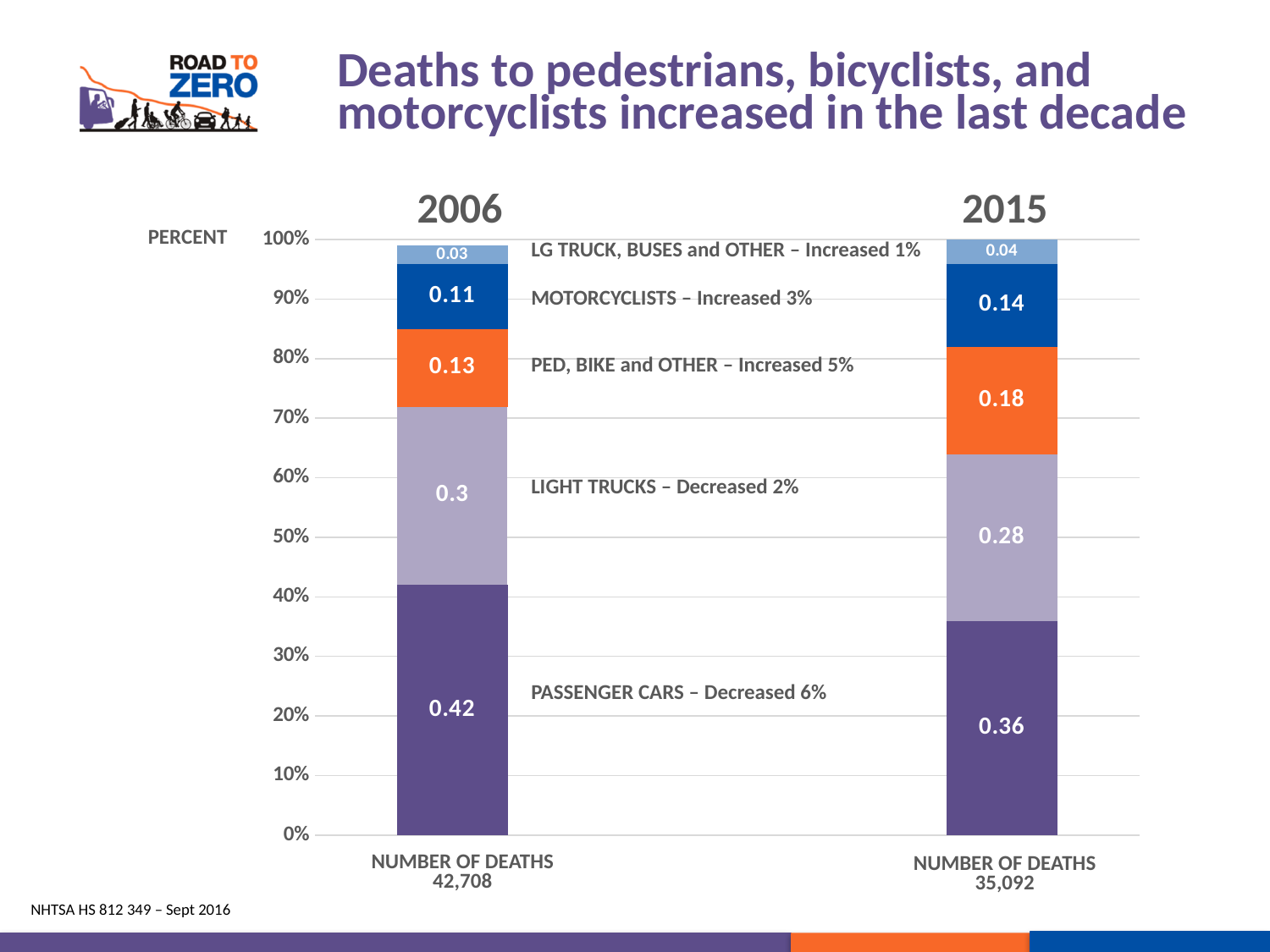
Which segment is the smallest in the 2015 bar? LG truck, buses and other What kind of chart is shown on the slide? stacked bar chart What is the difference between the passenger cars values for 2006 and 2015? 0.06 Which is larger, the ped, bike and other value in 2006 or in 2015? 2015 How many bars are plotted on the chart? 2 What is the value for passenger cars in the 2006 bar? 0.42 Which segment is the largest in the 2006 bar? Passenger cars What is the value for ped, bike and other in the 2015 bar? 0.18 What is the number of deaths shown under the 2015 bar? 35,092 What is the value for passenger cars in the 2015 bar? 0.36 What is the value for motorcyclists in the 2006 bar? 0.11 What is the value for light trucks in the 2015 bar? 0.28